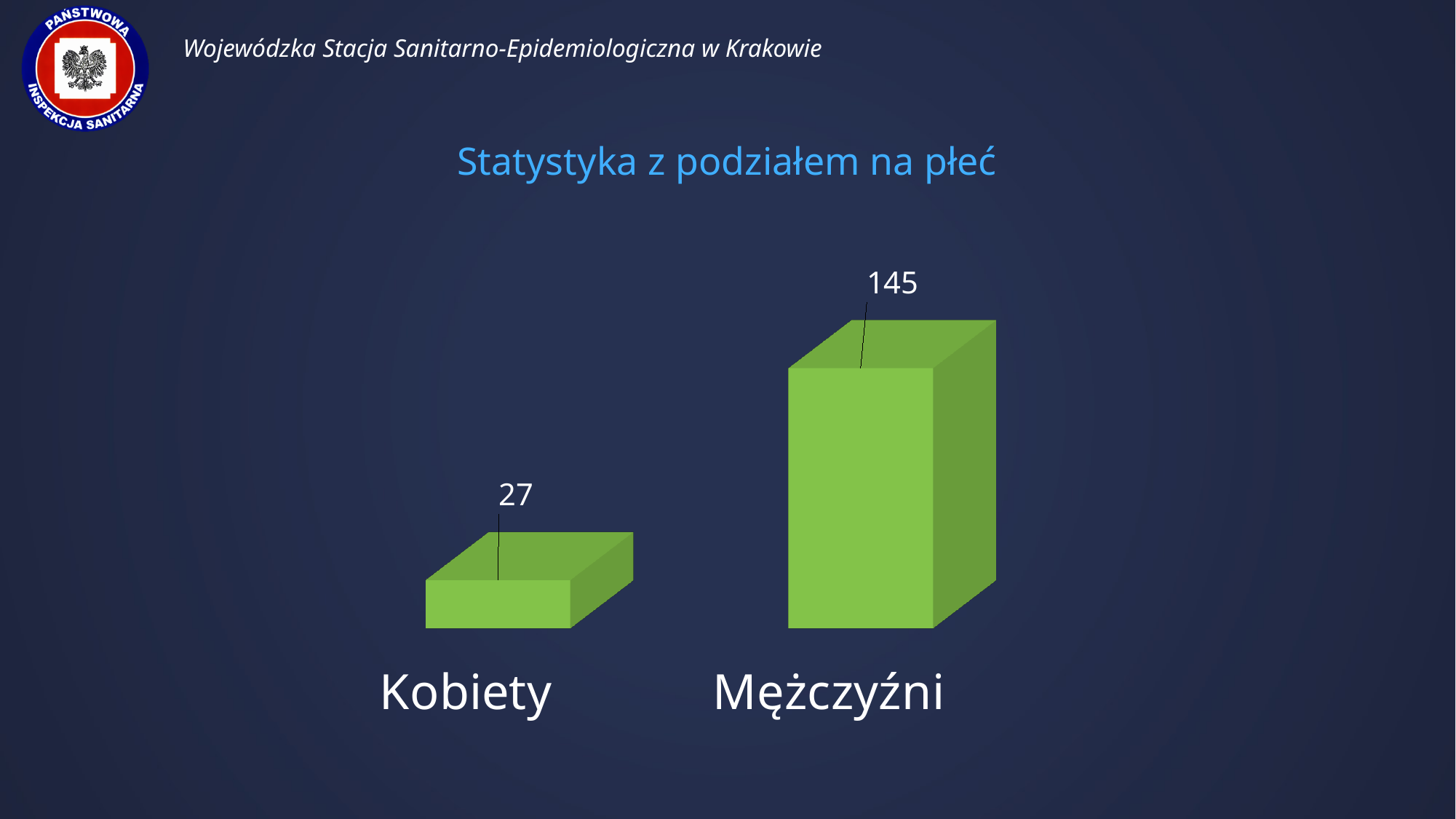
What is the title of the chart? Statystyka z podziałem na płeć What is the total of the values for Kobiety and Mężczyźni? 172 What colour are the bars in the chart? Green How many categories are shown in the chart? 2 Which category has the highest value? Mężczyźni Which category has the lowest value? Kobiety Which is larger, the value for Kobiety or the value for Mężczyźni? Mężczyźni What kind of chart is shown on the slide? Bar chart What is the value for Mężczyźni? 145 What is the difference between the values for Mężczyźni and Kobiety? 118 What is the value for Kobiety? 27